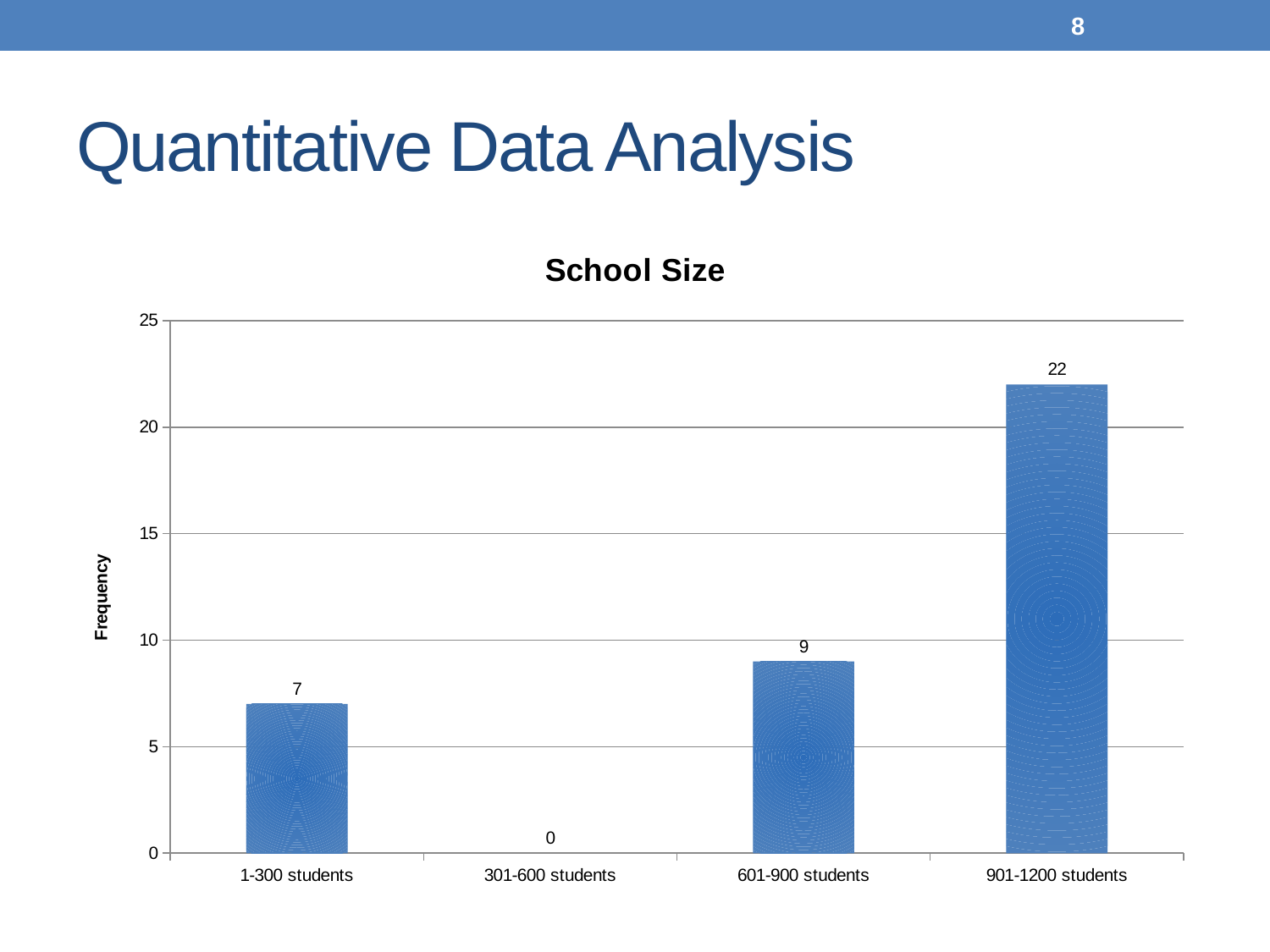
How many school size categories are shown on the chart? 4 Which school size category has the lowest frequency? 301-600 students Which has a higher frequency, 1-300 students or 601-900 students? 601-900 students What is the title of the chart? School Size Is the frequency for 901-1200 students greater or less than 20? greater What is the frequency for 301-600 students? 0 What is the frequency for 1-300 students? 7 What kind of chart is shown on the slide? bar chart What is the frequency for 901-1200 students? 22 What is the frequency for 601-900 students? 9 What is the difference in frequency between 901-1200 students and 601-900 students? 13 Which school size category has the highest frequency? 901-1200 students